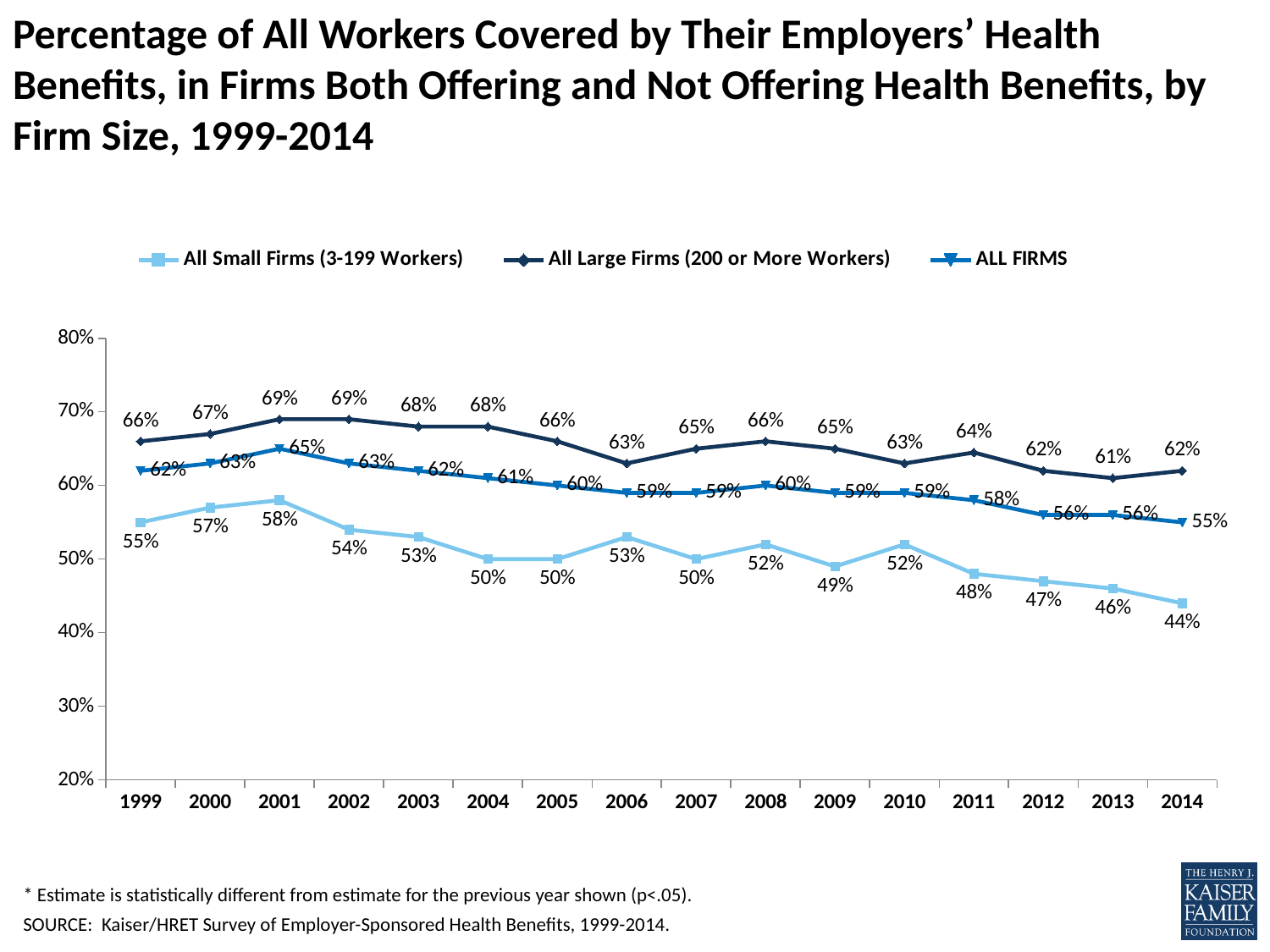
What was the value for All Large Firms (200 or More Workers) in 2001? 69% For All Large Firms (200 or More Workers), which year had the higher value, 2006 or 2007? 2007 By how many percentage points did the All Small Firms (3-199 Workers) value change from 1999 to 2014? 11 percentage points How many series does the legend list? 3 What kind of chart is shown on the slide? Line chart Does the All Small Firms (3-199 Workers) series generally rise or fall from 1999 to 2014? Fall In which year did All Small Firms (3-199 Workers) reach its highest value? 2001 How many years are shown on the x axis? 16 What percentage of workers in All Small Firms (3-199 Workers) were covered in 2014? 44% What is the difference between the All Large Firms and All Small Firms values in 2014? 18 percentage points In which year was the value for All Large Firms (200 or More Workers) lowest? 2013 What was the ALL FIRMS value in 2014? 55%